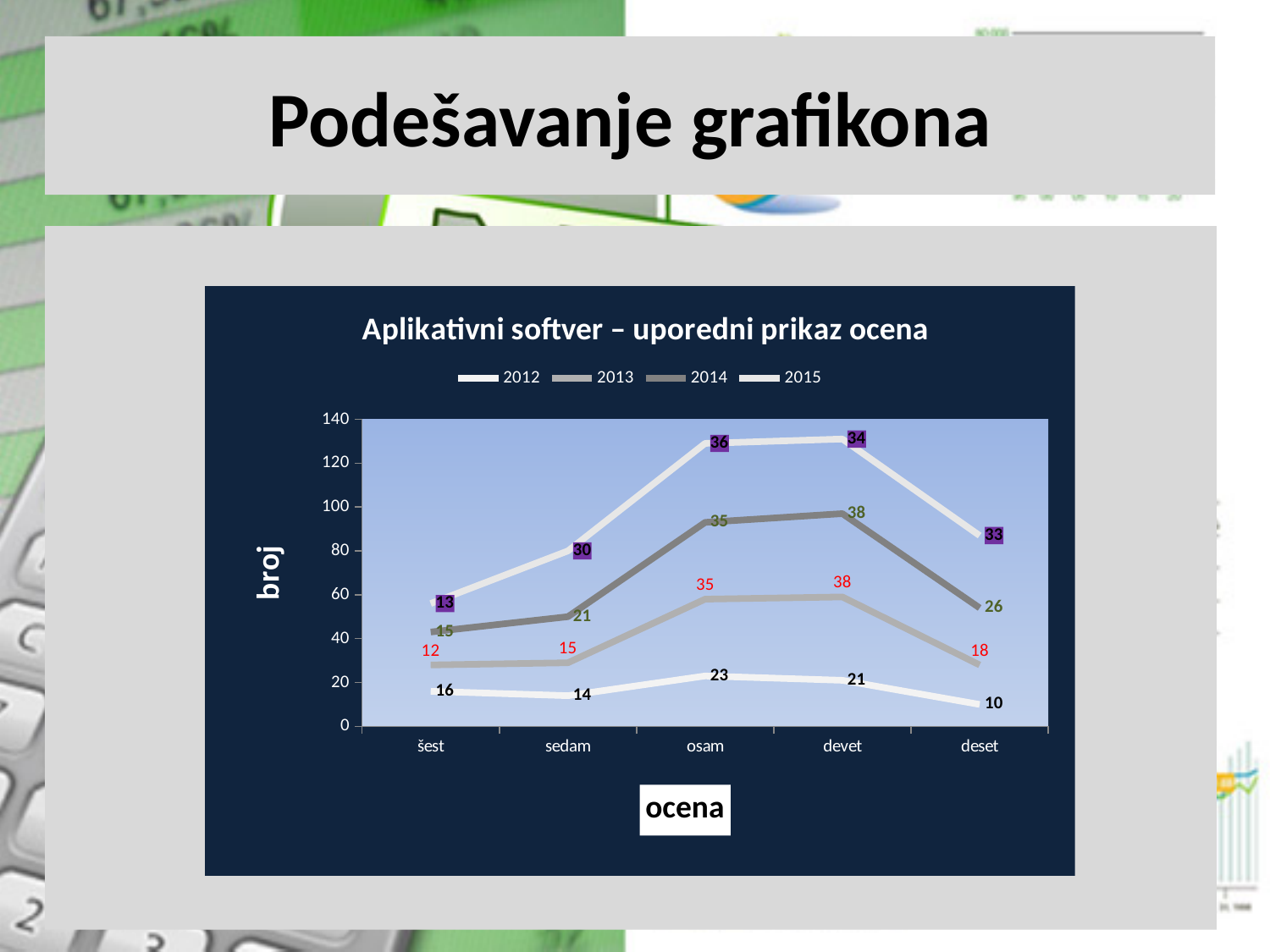
What is the value for 2015 at ocena "sedam"? 30 For the 2015 series, which ocena category has the highest value? osam How many series does the legend list? 4 At ocena "sedam", which series has the larger value, 2014 or 2015? 2015 What is the difference between the 2013 value at "osam" and the 2013 value at "šest"? 23 What is the value for 2012 at ocena "osam"? 23 What is the title of the chart? Aplikativni softver – uporedni prikaz ocena For the 2012 series, which ocena category has the lowest value? deset What kind of chart is shown on the slide? line chart What is the value for 2014 at ocena "deset"? 26 What is the value for 2013 at ocena "devet"? 38 How many ocena categories are shown on the x axis? 5